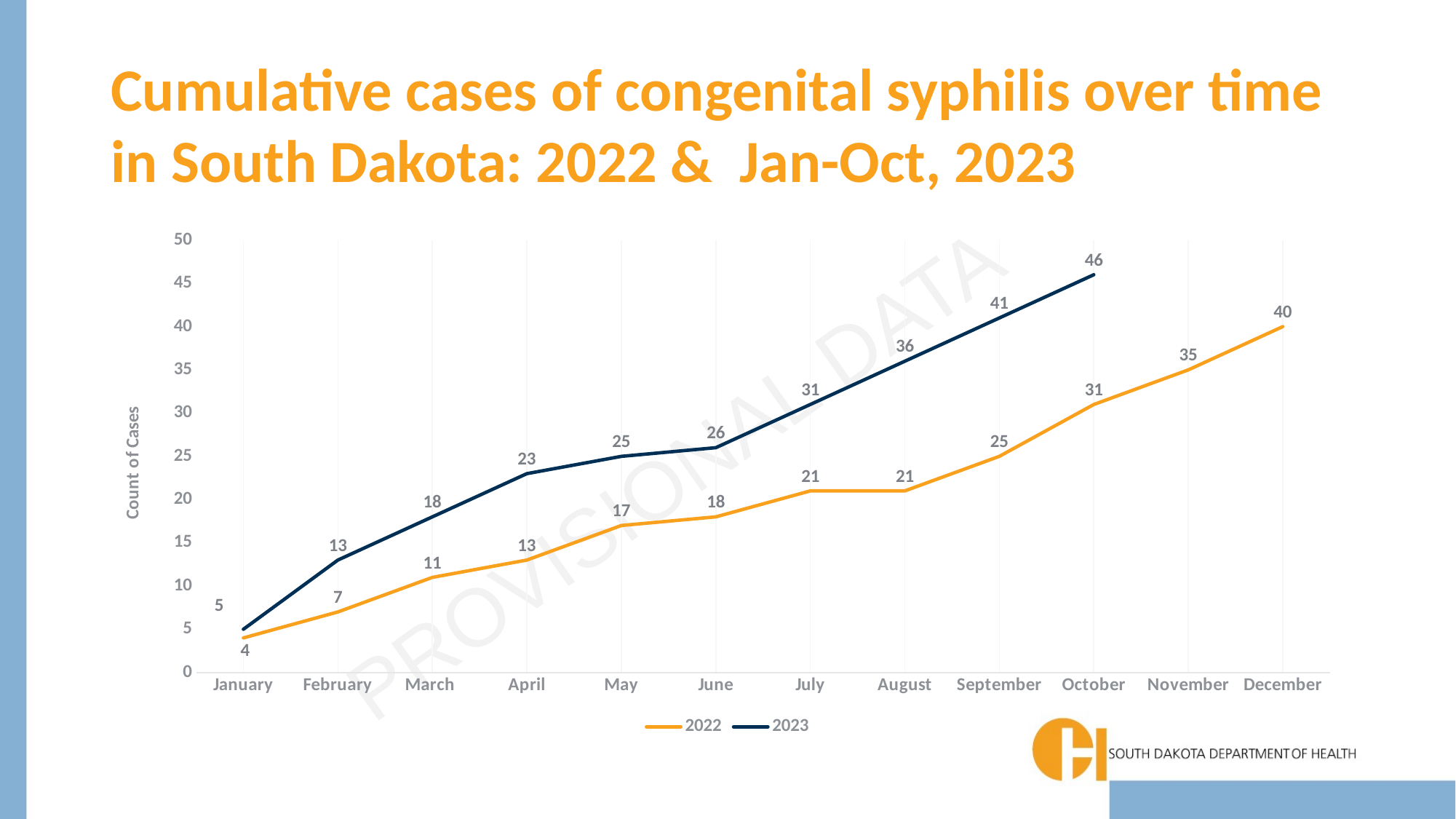
What is the cumulative count of cases for 2023 in April? 23 What is the cumulative count of cases for 2022 in December? 40 In which month is the 2023 series at its lowest cumulative count? January What kind of chart is shown on the slide? Line chart What is the cumulative count of cases for 2023 in October? 46 Which series has the higher cumulative count in September, 2022 or 2023? 2023 In which month does the 2022 series reach its highest cumulative count? December Do the 2022 values rise or fall from January to December? Rise What is the label of the vertical axis? Count of Cases What is the difference between the 2023 and 2022 cumulative counts in June? 8 What is the cumulative count of cases for 2022 in July? 21 How many series does the legend list? 2